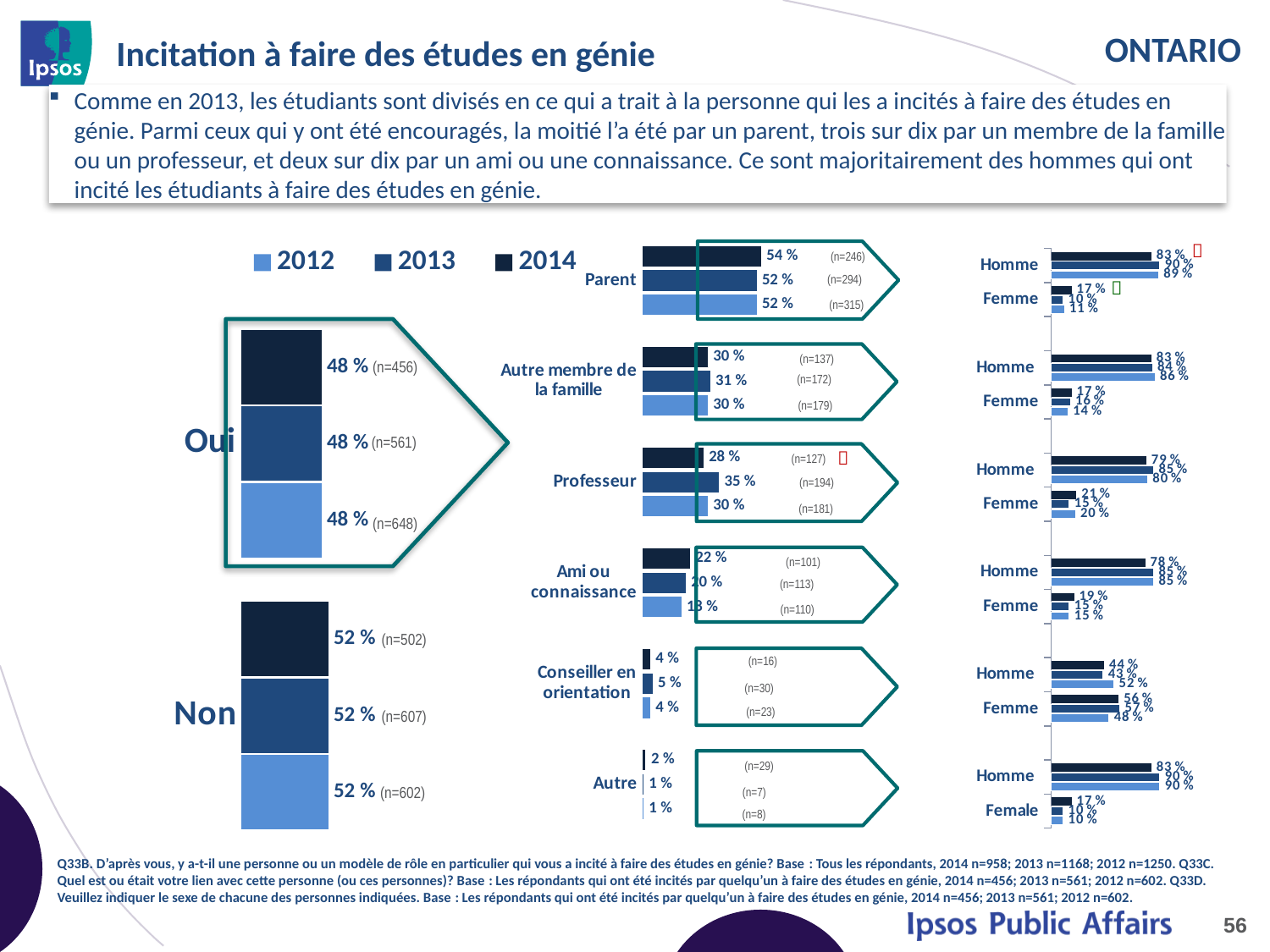
In the middle chart, what is the difference between the 2014 value for Parent (54 %) and the 2014 value for Autre membre de la famille (30 %)? 24 % In the middle chart, which is larger for Ami ou connaissance: the 2014 value or the 2012 value? 2014 In the left chart, what percentage of respondents answered Oui in 2014? 48 % In the right chart, for Conseiller en orientation, which is larger in 2014: Homme or Femme? Femme In the right chart, what percentage of the parents who encouraged students were men (Homme) in 2014? 83 % In the left chart, what is the sample size (n) for Non in 2012? n=602 In the middle chart, which relationship category has the lowest values? Autre How many series does the legend list on the slide? 3 In the middle chart, what is the 2013 value for Professeur? 35 % What type of chart is used on this slide? Bar chart In the middle chart, what percentage of students in 2014 were encouraged by a parent (Parent)? 54 % In the middle chart, which relationship category has the highest values across all years? Parent